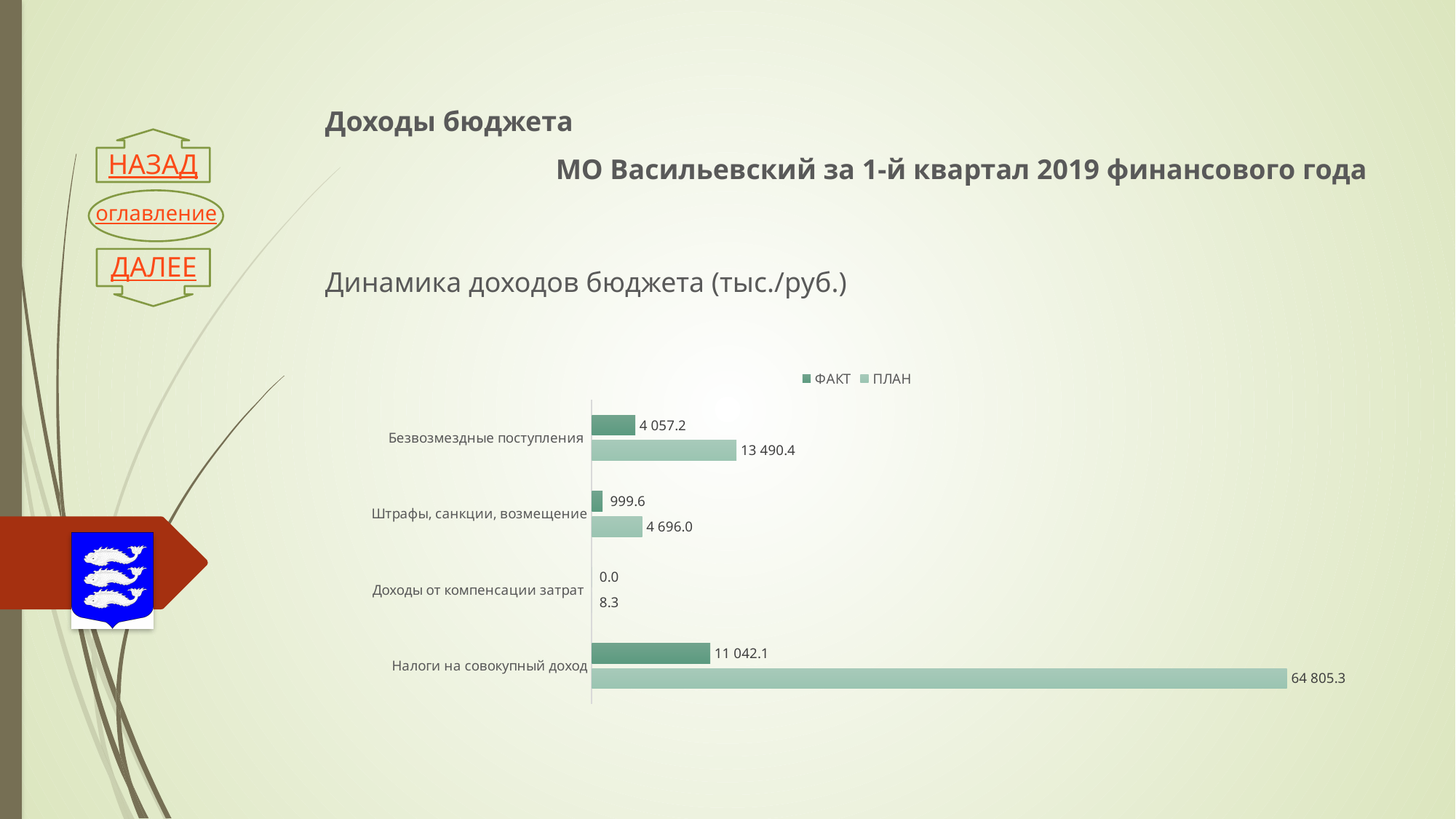
What is the difference between the ПЛАН and ФАКТ values for Безвозмездные поступления? 9 433.2 Which category has the highest ПЛАН value? Налоги на совокупный доход Which category has the lowest ФАКТ value? Доходы от компенсации затрат How many series does the legend list? 2 What is the difference between the ПЛАН and ФАКТ values for Налоги на совокупный доход? 53 763.2 How many categories are shown in the chart? 4 Which is larger for Штрафы, санкции, возмещение: the ФАКТ value or the ПЛАН value? ПЛАН What is the ПЛАН value for Штрафы, санкции, возмещение? 4 696.0 What kind of chart is shown on the slide? Bar chart What is the ФАКТ value for Доходы от компенсации затрат? 0.0 What is the ПЛАН value for Налоги на совокупный доход? 64 805.3 What is the ФАКТ value for Безвозмездные поступления? 4 057.2